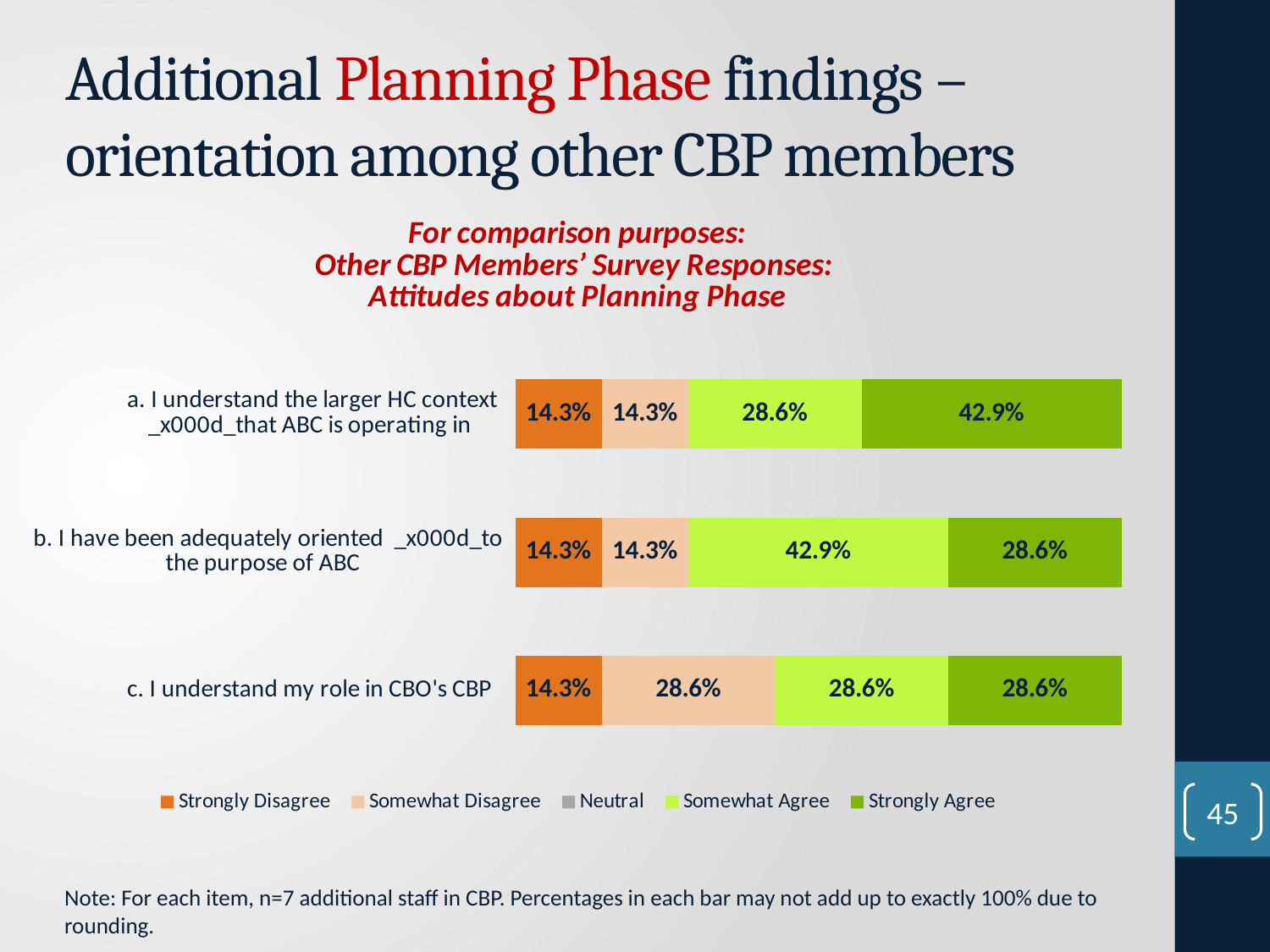
Which legend entry is represented by the dark orange colour in the chart? Strongly Disagree What is the Strongly Agree percentage for item a, "I understand the larger HC context that ABC is operating in"? 42.9% Which item has the highest Somewhat Disagree percentage? c. I understand my role in CBO's CBP What is the Strongly Disagree percentage for item a, "I understand the larger HC context that ABC is operating in"? 14.3% What is the Somewhat Agree percentage for item b, "I have been adequately oriented to the purpose of ABC"? 42.9% For item b, which is larger: the Somewhat Agree percentage or the Strongly Agree percentage? Somewhat Agree What is the difference between the Strongly Agree percentage for item a and the Strongly Agree percentage for item b? 14.3% What kind of chart is shown on the slide? Stacked bar chart How many series does the legend list? 5 What is the Somewhat Disagree percentage for item c, "I understand my role in CBO's CBP"? 28.6% Which item has the highest Strongly Agree percentage? a. I understand the larger HC context that ABC is operating in How many survey items (categories) are plotted in the chart? 3